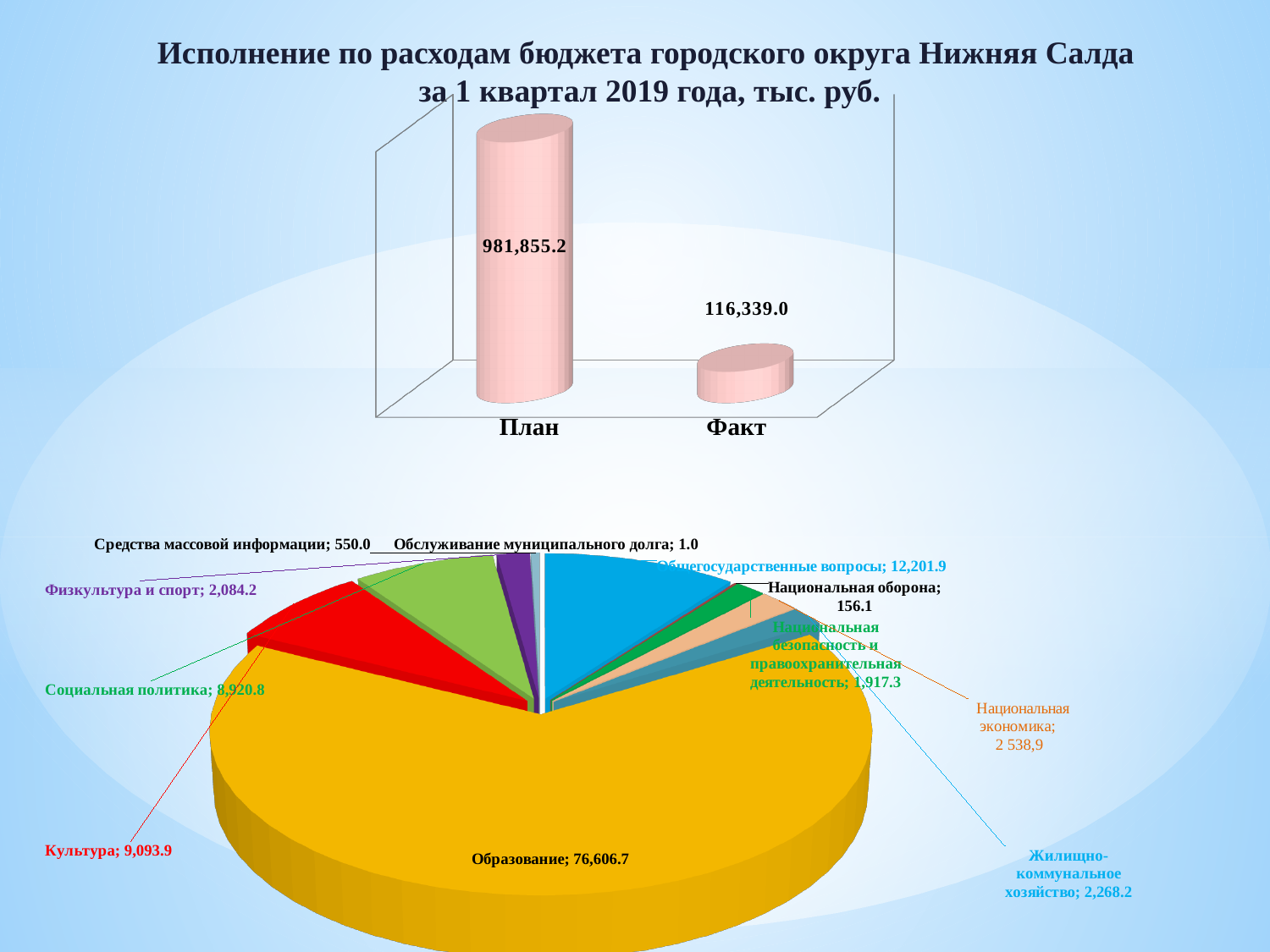
In the bar chart at the top of the slide, what is the value for Факт? 116,339.0 In the pie chart at the bottom of the slide, which category has the largest value? Образование In the pie chart at the bottom of the slide, what is the value for Национальная оборона? 156.1 In the pie chart at the bottom of the slide, what is the value for Образование? 76,606.7 In the pie chart at the bottom of the slide, which category has the smallest value? Обслуживание муниципального долга What kind of chart is the top chart on the slide? Bar chart What kind of chart is the bottom chart on the slide? Pie chart In the pie chart at the bottom of the slide, what is the difference between Культура and Социальная политика? 173.1 In the pie chart at the bottom of the slide, how many categories are shown? 11 In the bar chart at the top of the slide, which is larger, План or Факт? План In the bar chart at the top of the slide, what is the value for План? 981,855.2 In the bar chart at the top of the slide, what is the difference between План and Факт? 865,516.2